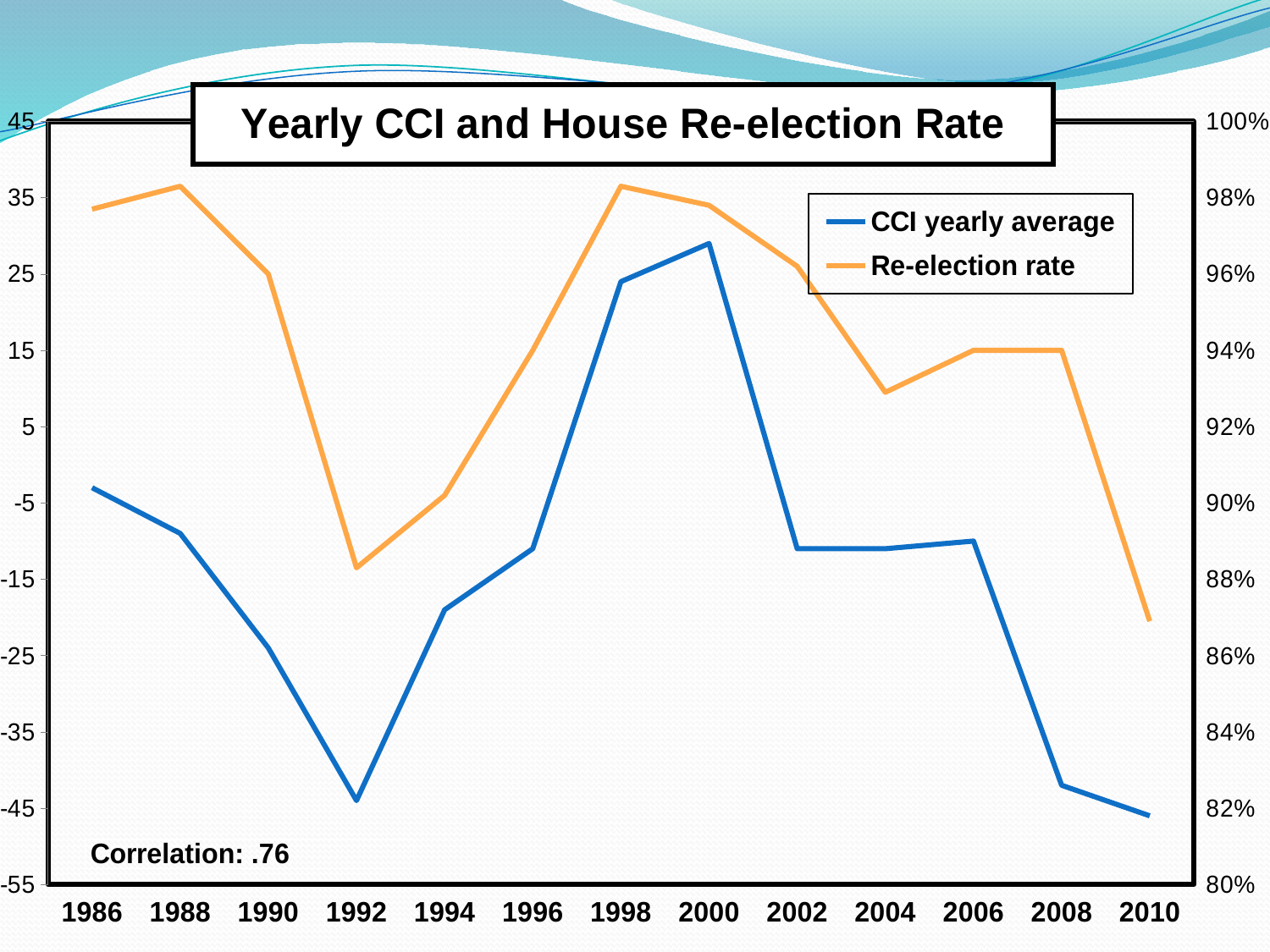
Is the CCI yearly average for 1992 greater or less than -35? less In which year is the CCI yearly average lowest? 2010 Is the CCI yearly average for 2000 greater or less than 25? greater Is the Re-election rate for 2010 greater or less than 88%? less In which year is the Re-election rate lowest? 2010 In which year is the CCI yearly average highest? 2000 Which year has the larger CCI yearly average, 1998 or 2002? 1998 What correlation value is printed on the chart? Correlation: .76 How many series does the legend list? 2 What kind of chart is shown on the slide? line chart How many years are plotted along the x axis? 13 Does the CCI yearly average rise or fall from 2000 to 2010? fall